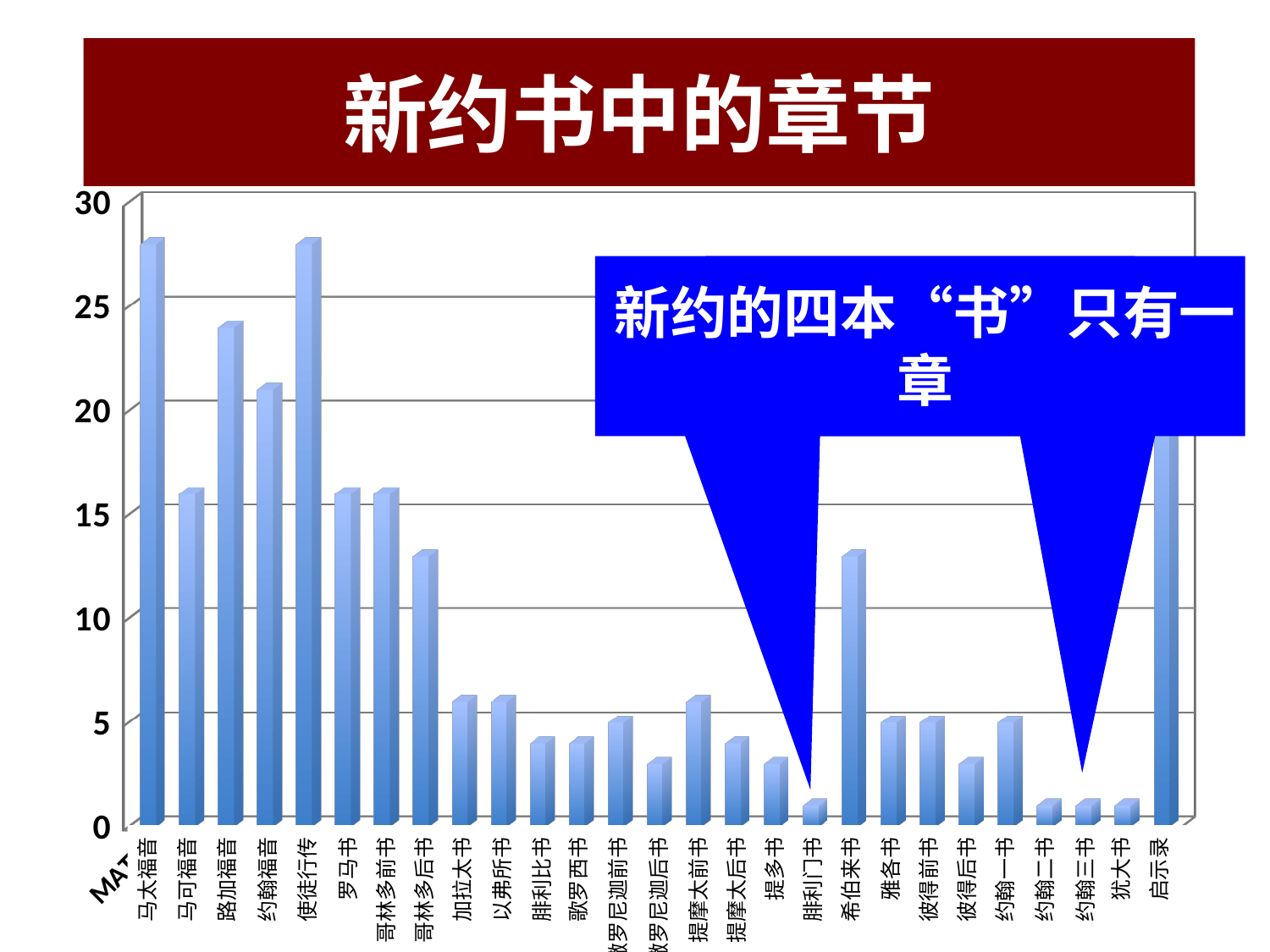
Which has the larger value, 希伯来书 or 提多书? 希伯来书 What does the blue callout box on the chart say? 新约的四本“书”只有一章 Is the value for 罗马书 greater or less than 10? greater Is the value for 哥林多后书 greater or less than 10? greater Is the value for 约翰福音 greater or less than 20? greater What is the title of the chart? 新约书中的章节 What kind of chart is shown on the slide? bar chart Which has the larger value, 路加福音 or 马可福音? 路加福音 How many books (categories) are plotted on the x axis? 27